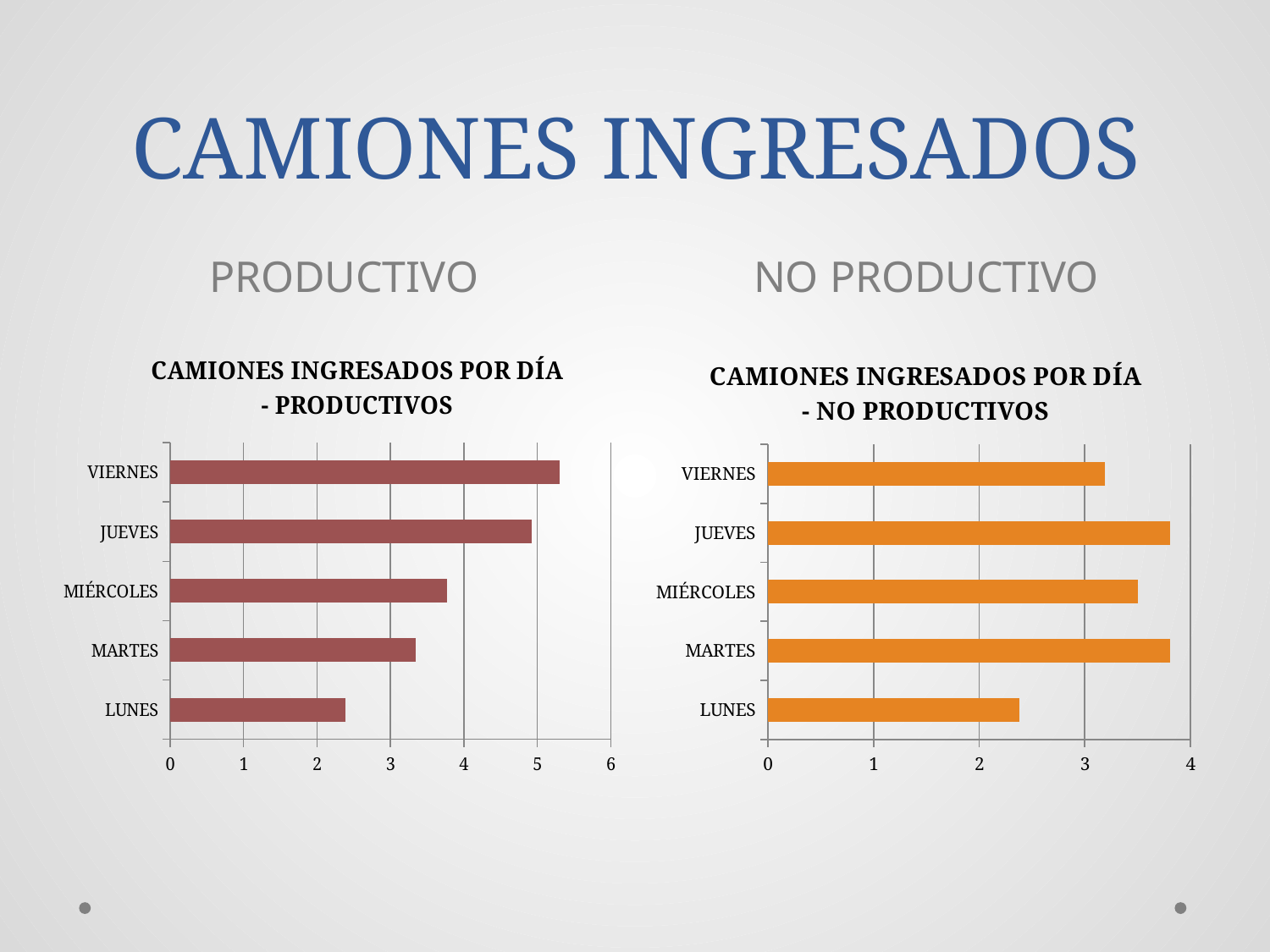
What kind of chart is the 'CAMIONES INGRESADOS POR DÍA - PRODUCTIVOS' chart? Bar chart In the 'CAMIONES INGRESADOS POR DÍA - PRODUCTIVOS' chart, which day has the lowest value? LUNES In the 'CAMIONES INGRESADOS POR DÍA - PRODUCTIVOS' chart, which is larger, the value for MIÉRCOLES or the value for MARTES? MIÉRCOLES In the 'CAMIONES INGRESADOS POR DÍA - PRODUCTIVOS' chart, which day has the highest value? VIERNES In the 'CAMIONES INGRESADOS POR DÍA - NO PRODUCTIVOS' chart, which is larger, the value for VIERNES or the value for MIÉRCOLES? MIÉRCOLES What colour are the bars in the 'CAMIONES INGRESADOS POR DÍA - NO PRODUCTIVOS' chart? Orange In the 'CAMIONES INGRESADOS POR DÍA - PRODUCTIVOS' chart, is the value for LUNES greater or less than 3? less In the 'CAMIONES INGRESADOS POR DÍA - PRODUCTIVOS' chart, is the value for VIERNES greater or less than 5? greater How many days are shown in the 'CAMIONES INGRESADOS POR DÍA - NO PRODUCTIVOS' chart? 5 In the 'CAMIONES INGRESADOS POR DÍA - NO PRODUCTIVOS' chart, is the value for LUNES greater or less than 3? less In the 'CAMIONES INGRESADOS POR DÍA - NO PRODUCTIVOS' chart, which day has the lowest value? LUNES